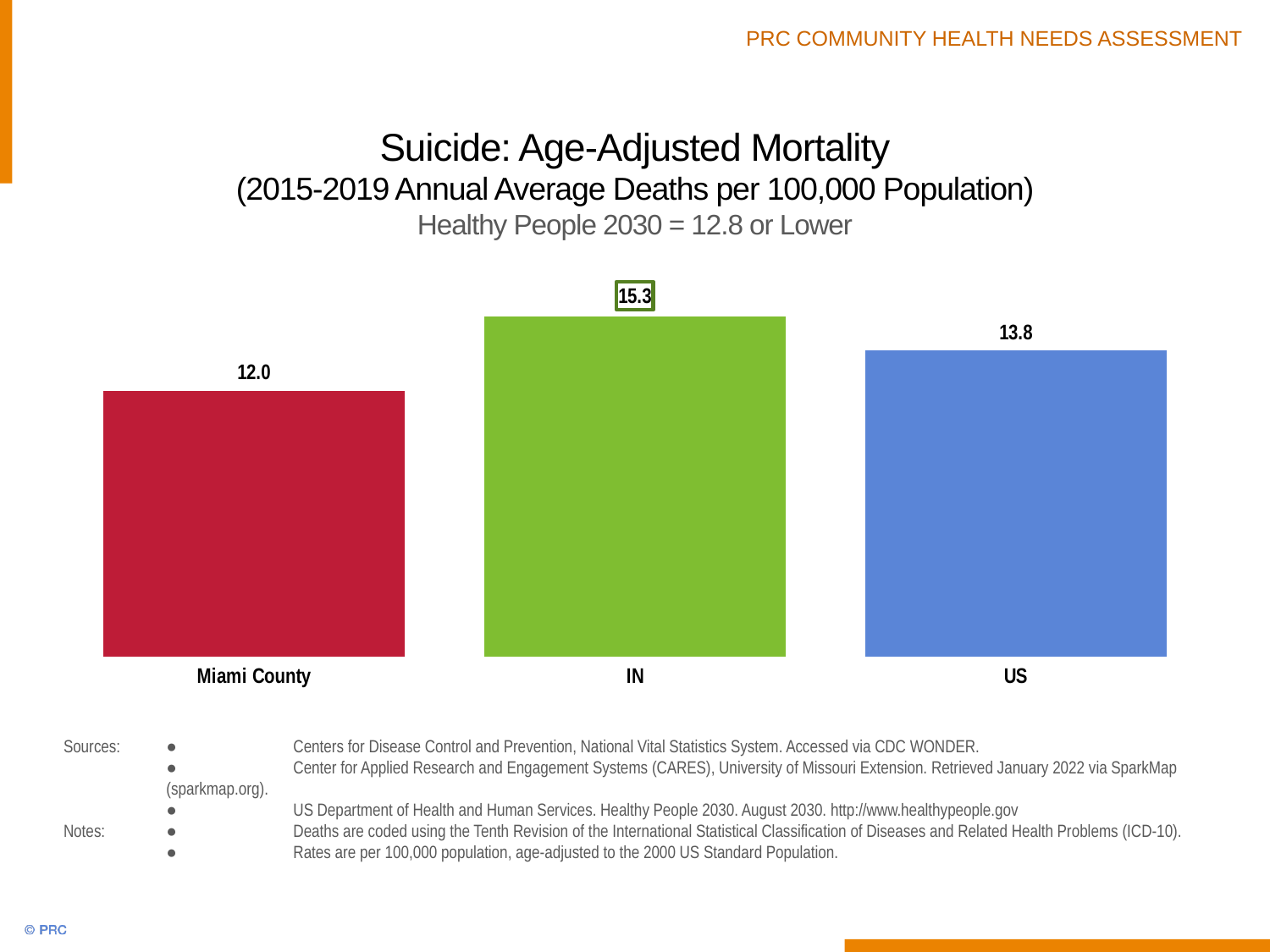
What is the Healthy People 2030 target stated in the chart subtitle? 12.8 or Lower What is the difference between the US rate and the Miami County rate? 1.8 What is the suicide age-adjusted mortality rate for the US? 13.8 How many categories are shown in the chart? 3 What colour is the bar for Miami County? Red What is the suicide age-adjusted mortality rate for IN? 15.3 What is the suicide age-adjusted mortality rate for Miami County? 12.0 Which is larger, the rate for IN or the rate for the US? IN Which category has the highest suicide mortality rate? IN Which category has the lowest suicide mortality rate? Miami County What is the difference between the IN rate and the Miami County rate? 3.3 What kind of chart is shown on the slide? Bar chart